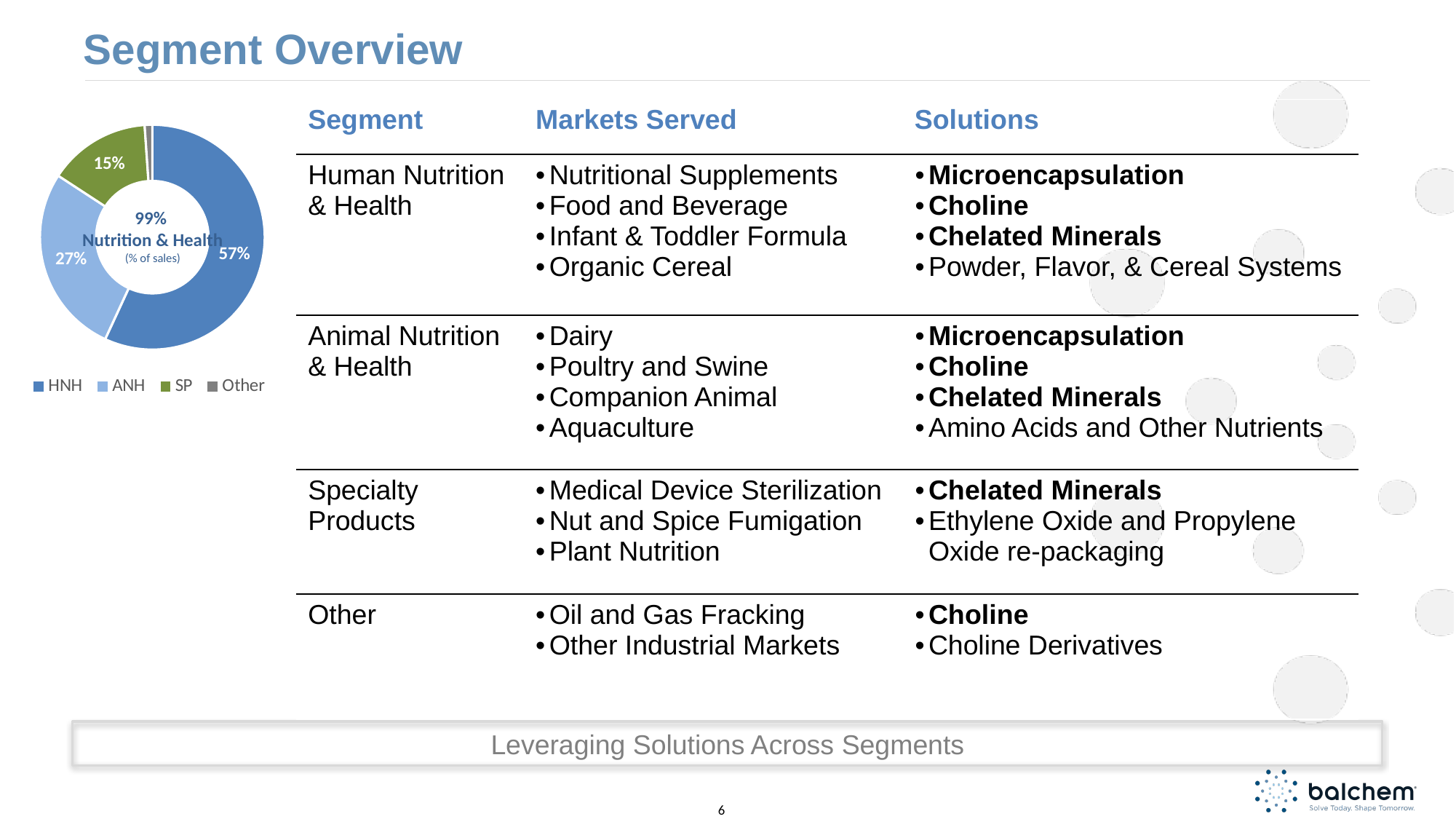
What colour is the SP segment in the pie chart? green What kind of chart is shown on the left of the slide? doughnut chart How many percentage points larger is the HNH share than the ANH share in the pie chart? 30 According to the text in the centre of the pie chart, what percentage of sales comes from Nutrition & Health? 99% What share of sales does the HNH segment represent in the pie chart? 57% How many segments does the legend of the pie chart list? 4 What share of sales does the SP segment represent in the pie chart? 15% Which segment has the largest share in the pie chart? HNH How many percentage points larger is the ANH share than the SP share in the pie chart? 12 Which segment has the smallest share in the pie chart? Other Which segment has a larger share in the pie chart, ANH or SP? ANH What share of sales does the ANH segment represent in the pie chart? 27%